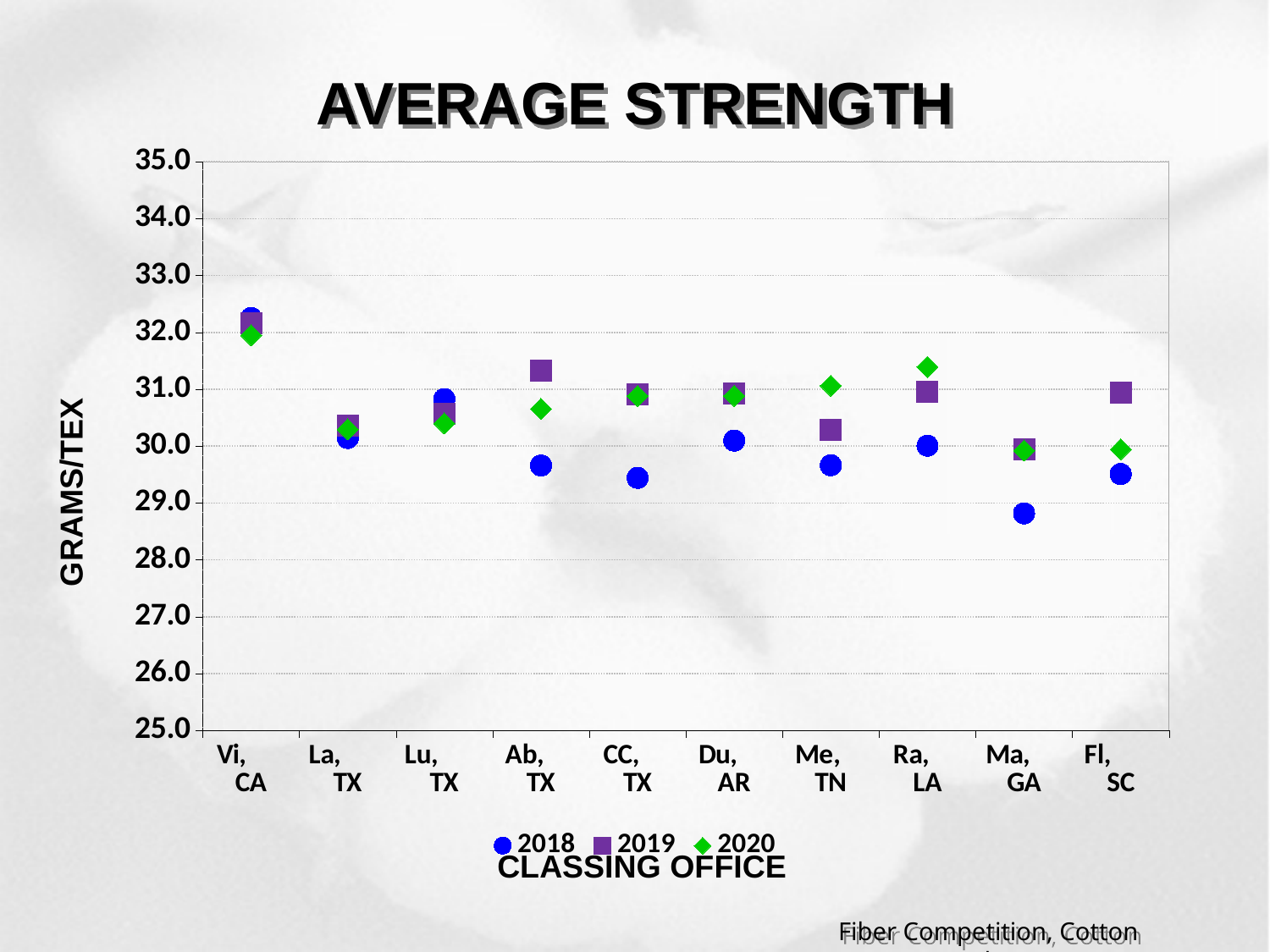
Which classing office has the highest 2018 average strength? Vi, CA Which classing office has the lowest 2018 average strength? Ma, GA Is the 2019 value for Ab, TX greater or less than 31.0? greater How many classing offices are shown on the x axis? 10 Is the 2018 value for Ma, GA greater or less than 29.0? less Which classing office has the highest 2020 average strength? Vi, CA What is the label on the y axis of the chart? GRAMS/TEX What kind of chart is shown on the slide? scatter chart Is the 2018 value for CC, TX greater or less than 30.0? less For Me, TN, which series has the larger value, 2018 or 2020? 2020 How many series does the legend list? 3 For Ab, TX, which series has the larger value, 2018 or 2019? 2019